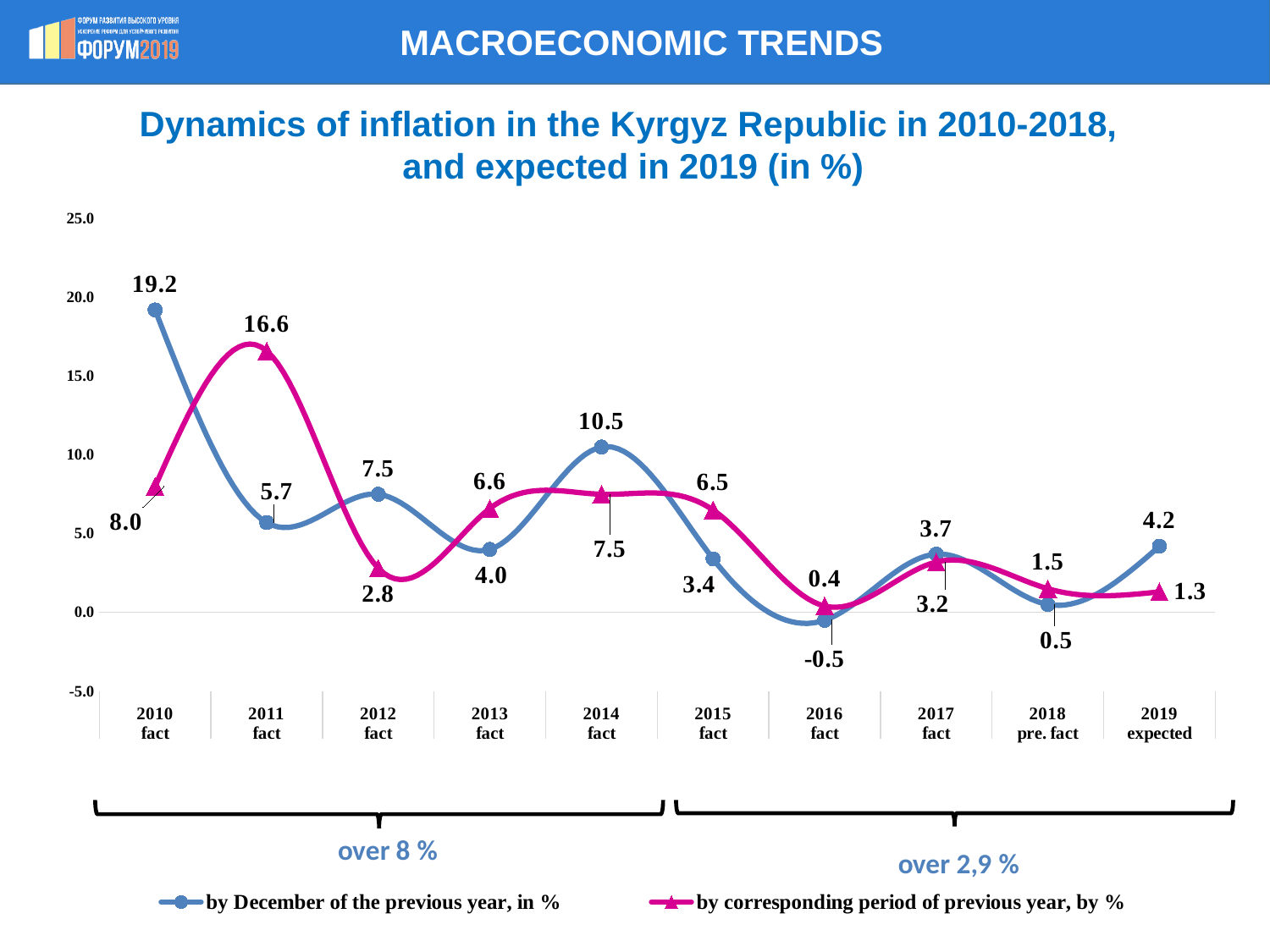
How many years are shown on the x axis? 10 Which year has the highest value in the 'by December of the previous year, in %' series? 2010 What kind of chart is shown on the slide? line chart What is the difference between the 2014 and 2013 values in the 'by December of the previous year, in %' series? 6.5 Which year has the lowest value in the 'by corresponding period of previous year, by %' series? 2016 What is the expected 2019 value in the 'by corresponding period of previous year, by %' series? 1.3 What is the value for 2011 in the 'by corresponding period of previous year, by %' series? 16.6 What is the value for 2010 in the 'by December of the previous year, in %' series? 19.2 How many series does the legend list? 2 What is the value for 2016 in the 'by December of the previous year, in %' series? -0.5 What label is shown under the bracket covering 2010-2014? over 8 % In 2015, which series has the larger value: 'by December of the previous year' or 'by corresponding period of previous year'? by corresponding period of previous year, by %